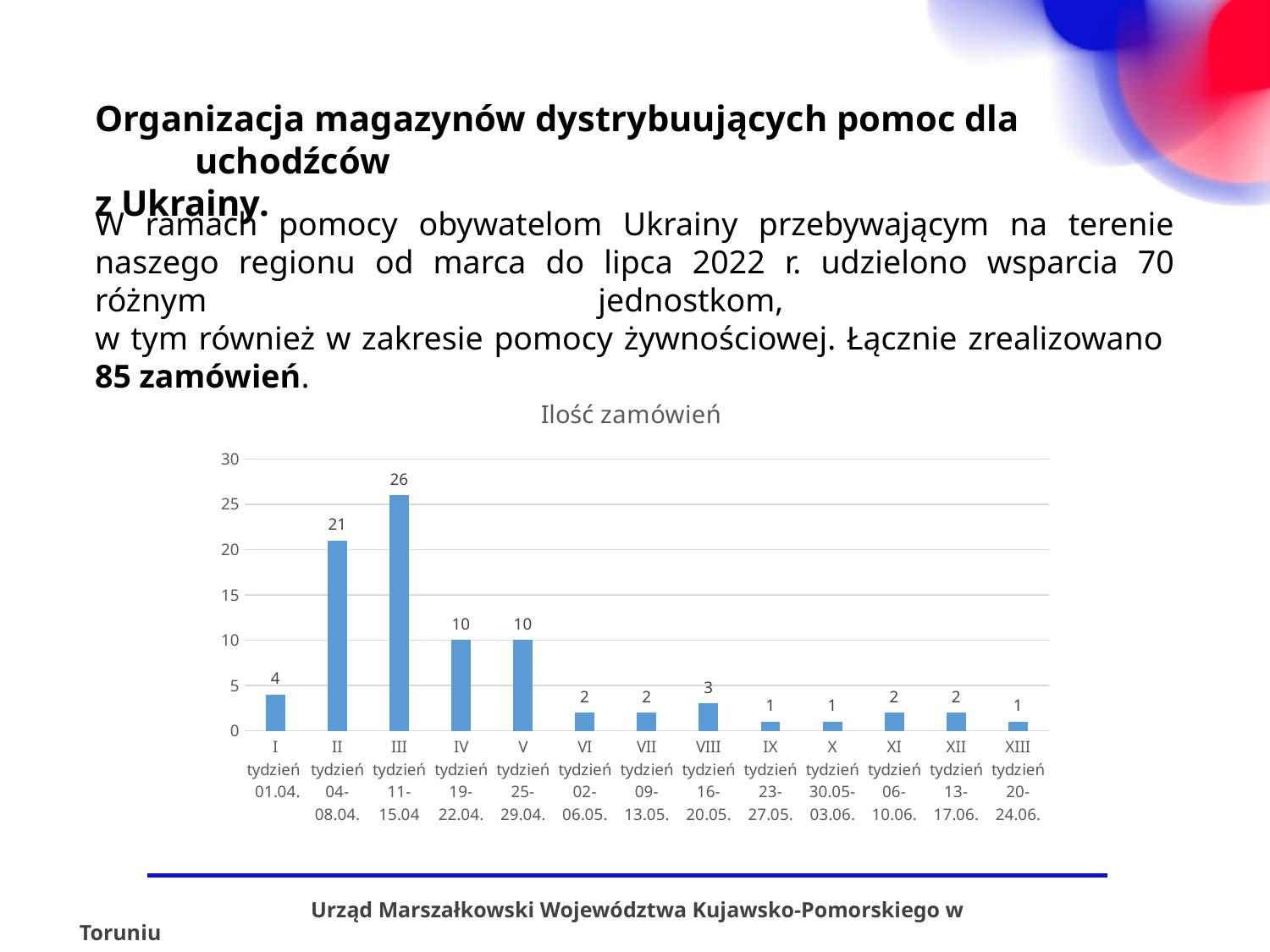
What is the total of all the values shown in the chart? 85 What is the value for III tydzień (11-15.04)? 26 What is the difference between the values for III tydzień and II tydzień? 5 What is the title of the chart? Ilość zamówień Which is larger, the value for I tydzień or the value for VIII tydzień? I tydzień What is the value for VIII tydzień (16-20.05)? 3 Is the value for IV tydzień (19-22.04) greater or less than 15? less How many weeks (categories) are shown on the x axis of the chart? 13 What is the value for I tydzień (01.04.)? 4 Which week has the highest number of orders? III tydzień (11-15.04) What kind of chart is shown on the slide? bar chart What is the value for II tydzień (04-08.04)? 21